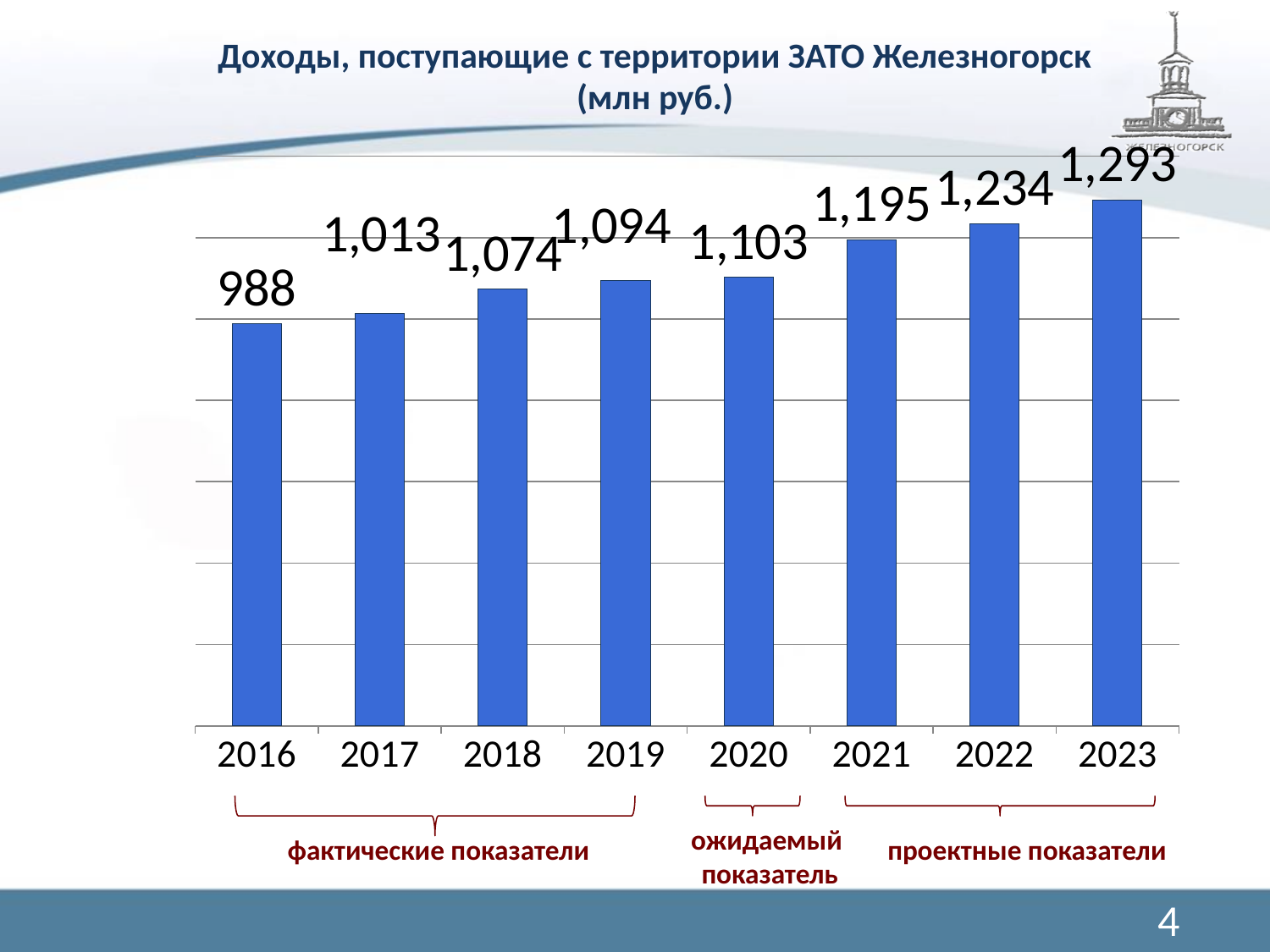
What is the value for 2020? 1,103 Which year has the lowest value? 2016 Which year has the highest value? 2023 What is the value for 2016? 988 What is the value for 2023? 1,293 What is the difference between the values for 2023 and 2016? 305 What kind of chart is shown on the slide? bar chart How many years are shown on the x axis? 8 In what units are the values given, according to the chart title? млн руб. Which is larger, the value for 2018 or the value for 2021? 2021 What is the difference between the values for 2022 and 2021? 39 Do the values rise or fall from 2016 to 2023? rise